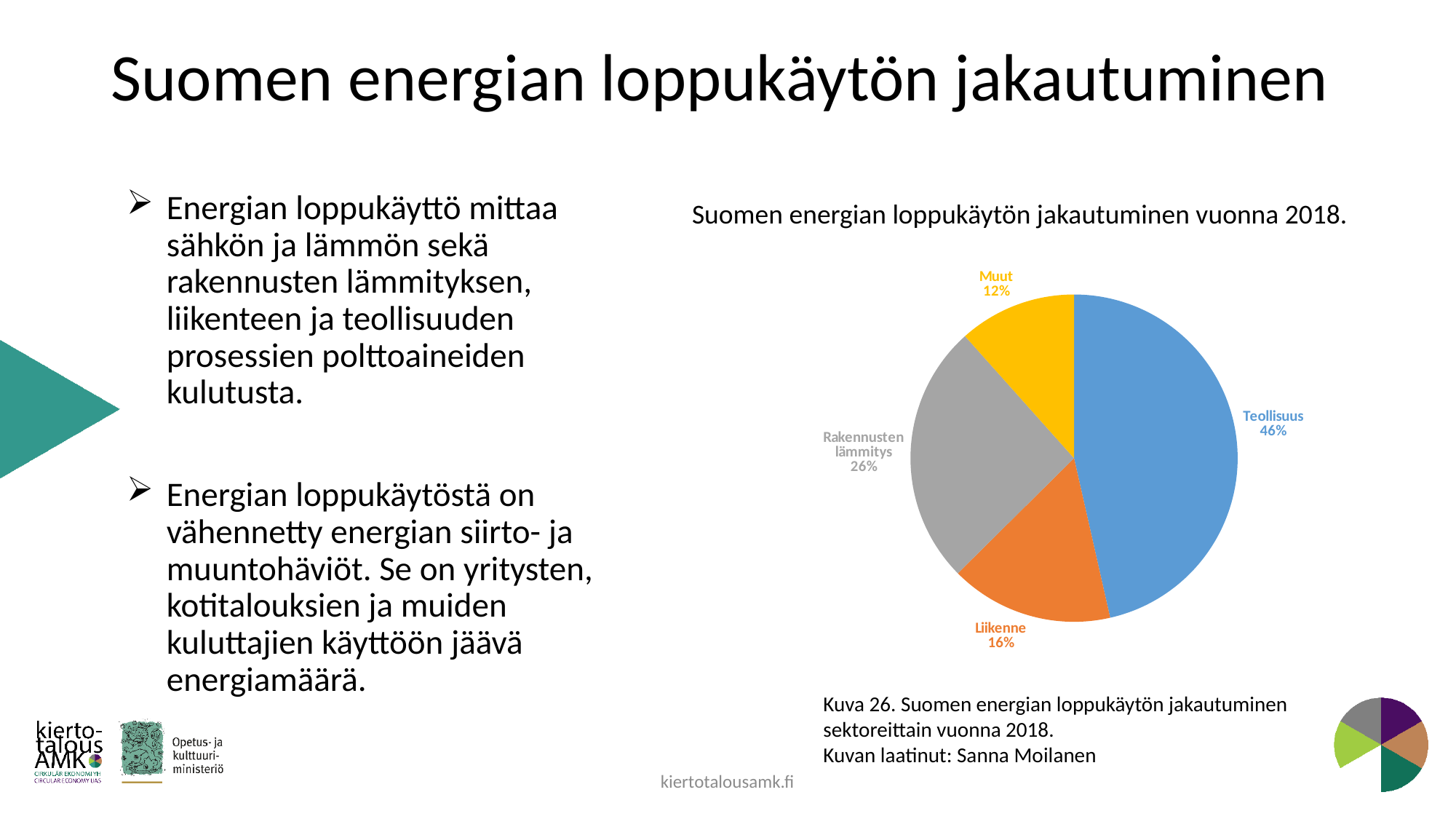
Which is larger, the share for Liikenne or the share for Muut? Liikenne What is the title of the pie chart? Suomen energian loppukäytön jakautuminen vuonna 2018. What colour is the Teollisuus slice? blue What percentage is shown for Liikenne? 16% How many slices does the pie chart have? 4 Which sector has the largest share of the pie? Teollisuus What percentage is shown for Rakennusten lämmitys? 26% What percentage is shown for Muut? 12% Which sector has the smallest share of the pie? Muut What is the difference in percentage points between Teollisuus and Rakennusten lämmitys? 20 What share of Finland's final energy use in 2018 does Teollisuus account for? 46% What type of chart is shown on the slide? pie chart